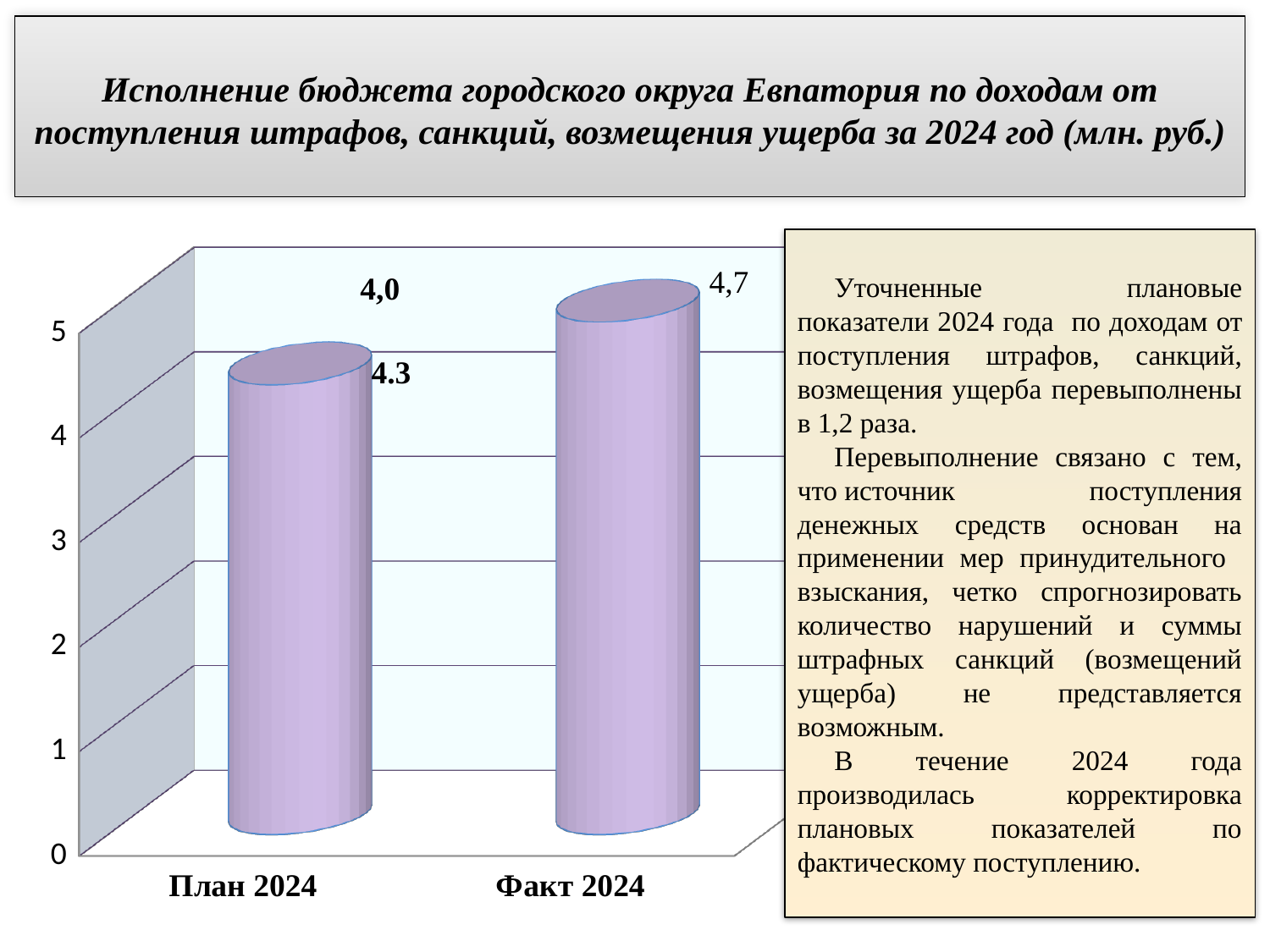
Which category has the lowest value? План 2024 Which category has the highest value, План 2024 or Факт 2024? Факт 2024 What is the highest tick value shown on the vertical axis? 5 What kind of chart is shown on the slide? Bar chart How many categories are shown on the chart? 2 Is the value for Факт 2024 larger than the value for План 2024? Yes Is the value for Факт 2024 greater or less than 4? greater Is the value for План 2024 greater or less than 3? greater What is the value for Факт 2024? 4,7 Do the values rise or fall from План 2024 to Факт 2024? Rise What are the two category labels on the horizontal axis? План 2024 and Факт 2024